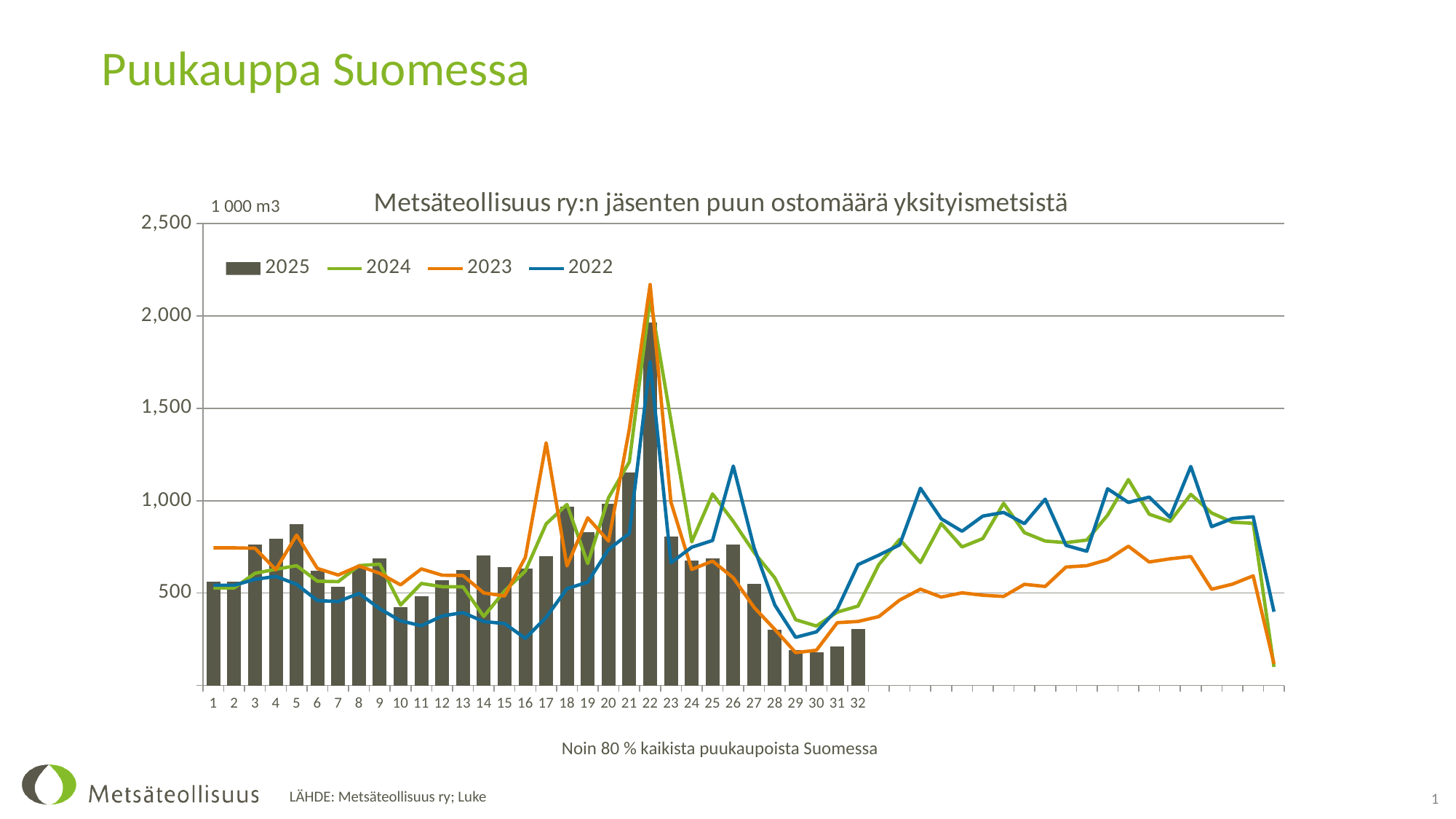
Do the 2025 bars rise or fall from week 22 to week 30? Fall What unit is shown above the vertical axis? 1 000 m3 What kind of chart is this? Combined bar and line chart Is the 2022 line value at week 16 greater or less than 500? less Which 2025 bar is larger, week 5 or week 10? Week 5 Is the 2023 line value at week 22 greater or less than 2,000? greater Is the 2025 bar for week 30 greater or less than 500? less What is the title of the chart? Metsäteollisuus ry:n jäsenten puun ostomäärä yksityismetsistä How many series does the legend list? 4 How many bars are plotted for the 2025 series? 32 Which week has the highest 2025 bar? 22